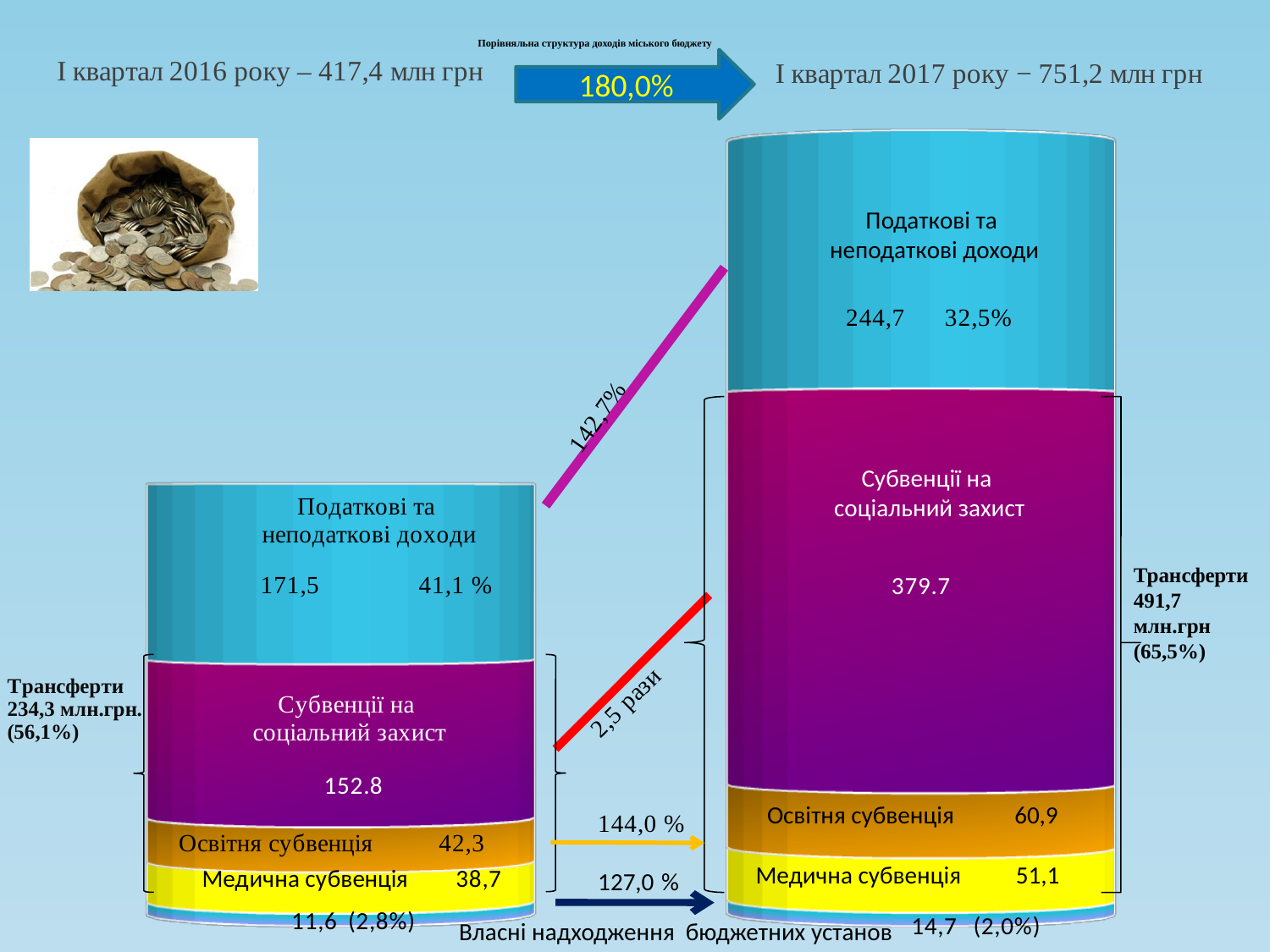
In the I квартал 2017 року chart, what is the value for Освітня субвенція? 60,9 What is the value and share of Трансферти in the I квартал 2017 року chart? 491,7 млн.грн (65,5%) Which segment is the largest in the I квартал 2017 року chart? Субвенції на соціальний захист Which is larger: Медична субвенція in I квартал 2016 року or Освітня субвенція in I квартал 2016 року? Освітня субвенція What is the difference between Освітня субвенція in I квартал 2017 року and in I квартал 2016 року? 18,6 What growth percentage is shown on the arrow between the two quarter totals at the top of the slide? 180,0% In the I квартал 2016 року chart, what is the value for Медична субвенція? 38,7 In the I квартал 2016 року chart, what is the value for Податкові та неподаткові доходи? 171,5 What is the total revenue shown for I квартал 2017 року? 751,2 млн грн In the I квартал 2017 року chart, what is the value for Субвенції на соціальний захист? 379.7 What percentage share do Податкові та неподаткові доходи have in the I квартал 2016 року chart? 41,1 % Which segment is the smallest in the I квартал 2016 року chart? Власні надходження бюджетних установ